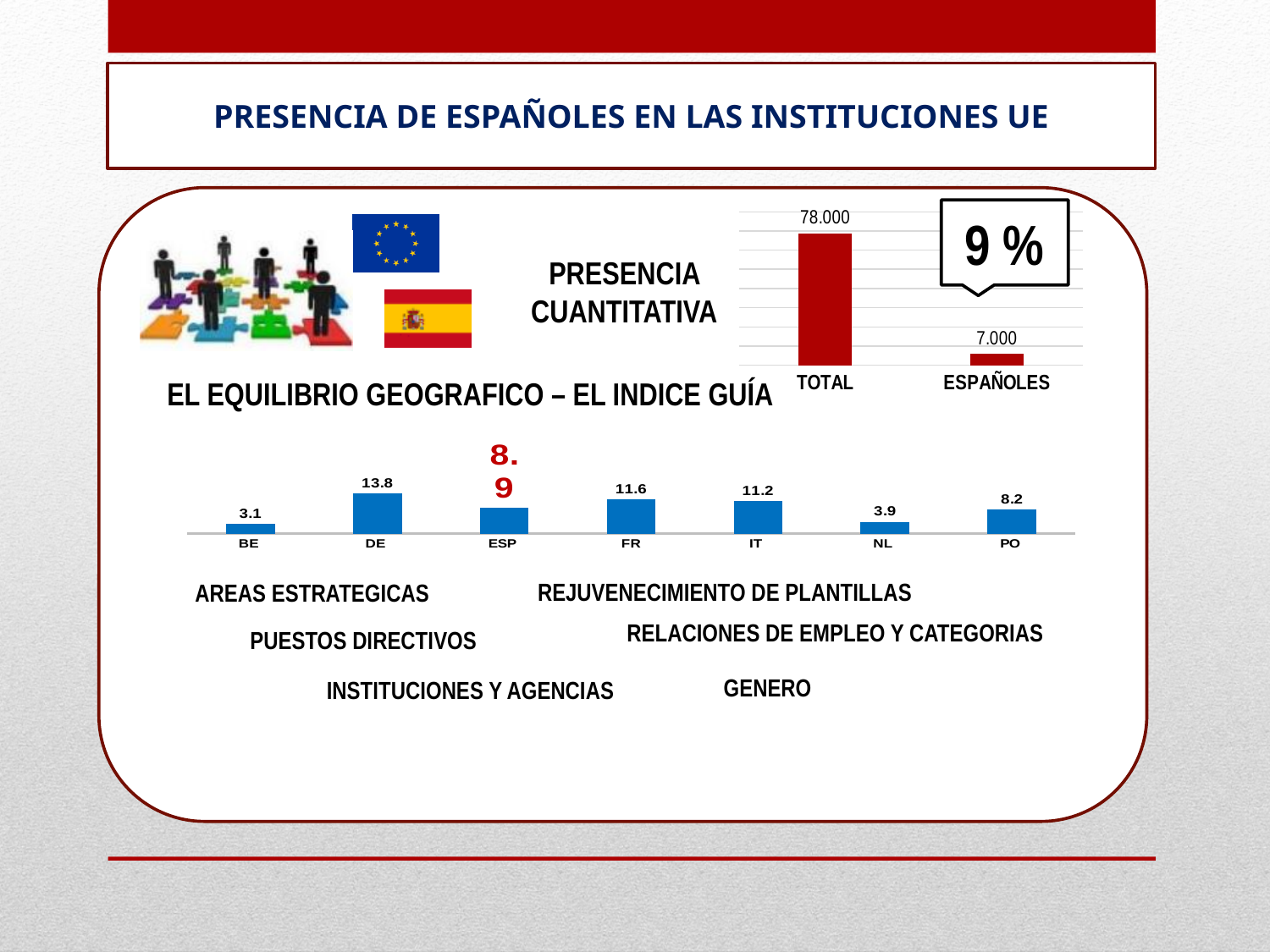
In the bottom bar chart, which category has the highest value? DE In the top-right bar chart, what is the value for TOTAL? 78.000 In the top-right bar chart, what is the value for ESPAÑOLES? 7.000 In the bottom bar chart, what is the difference between the values for FR and IT? 0.4 How many categories are shown in the bottom bar chart? 7 In the bottom bar chart, what is the value for ESP? 8.9 In the bottom bar chart, which is larger, the value for NL or the value for PO? PO What percentage is shown in the callout box next to the top-right chart? 9 % What kind of chart is the top-right chart showing TOTAL and ESPAÑOLES? bar chart In the top-right bar chart, how many categories are shown? 2 In the bottom bar chart, which category has the lowest value? BE In the bottom bar chart, what is the value for DE? 13.8